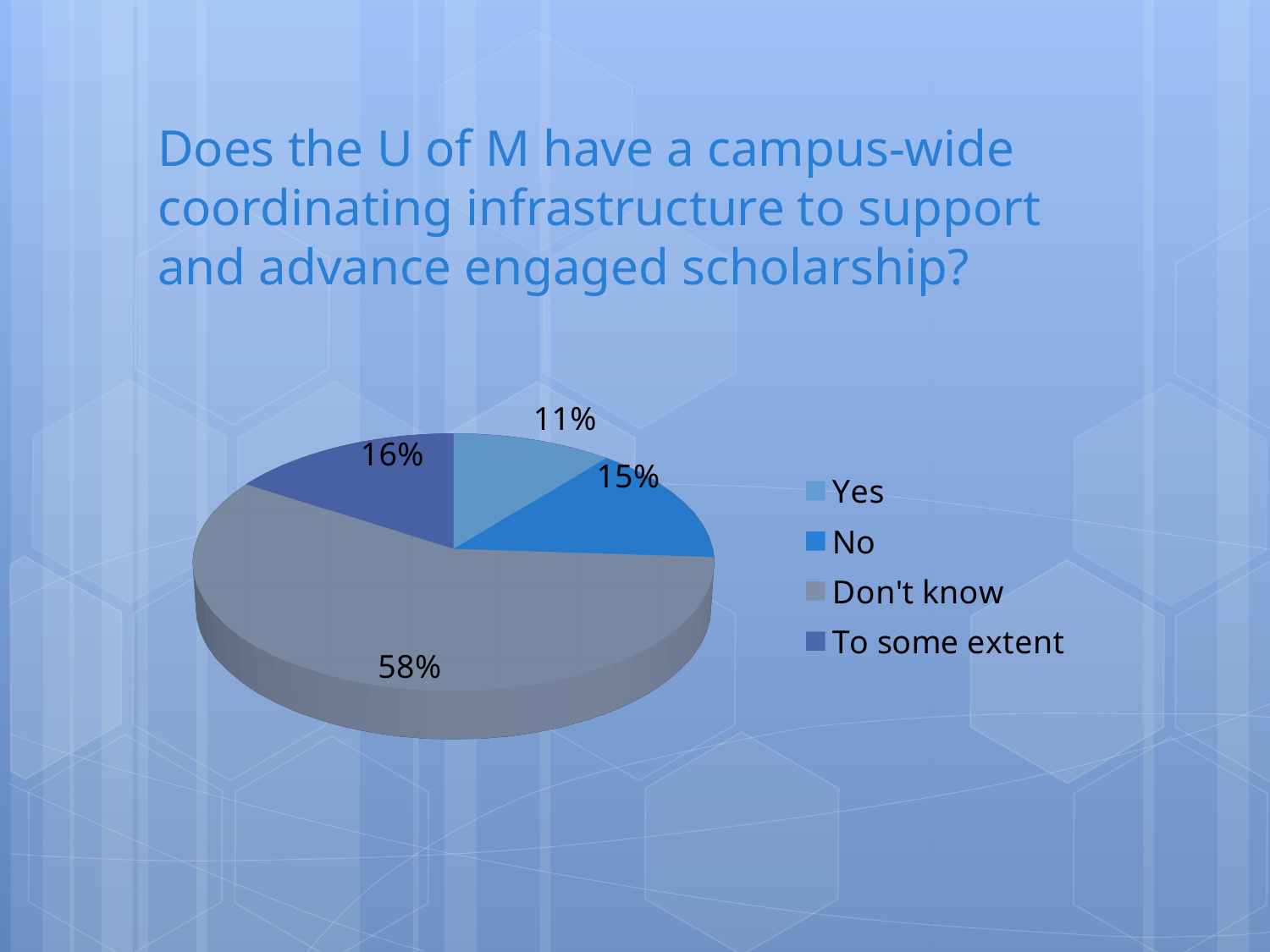
What is the difference in percentage points between "Don't know" and "To some extent"? 42 What is the combined percentage of "Yes" and "No" responses? 26% Which response has the smallest share of the pie? Yes What percentage of respondents answered "To some extent"? 16% What percentage of respondents answered "No"? 15% What percentage of respondents answered "Don't know"? 58% How many categories does the legend list? 4 What percentage of respondents answered "Yes"? 11% What type of chart is shown on the slide? Pie chart Which response has the largest share of the pie? Don't know Which is larger, the share for "No" or the share for "Yes"? No Which colour represents "Don't know" in the pie chart? Grey